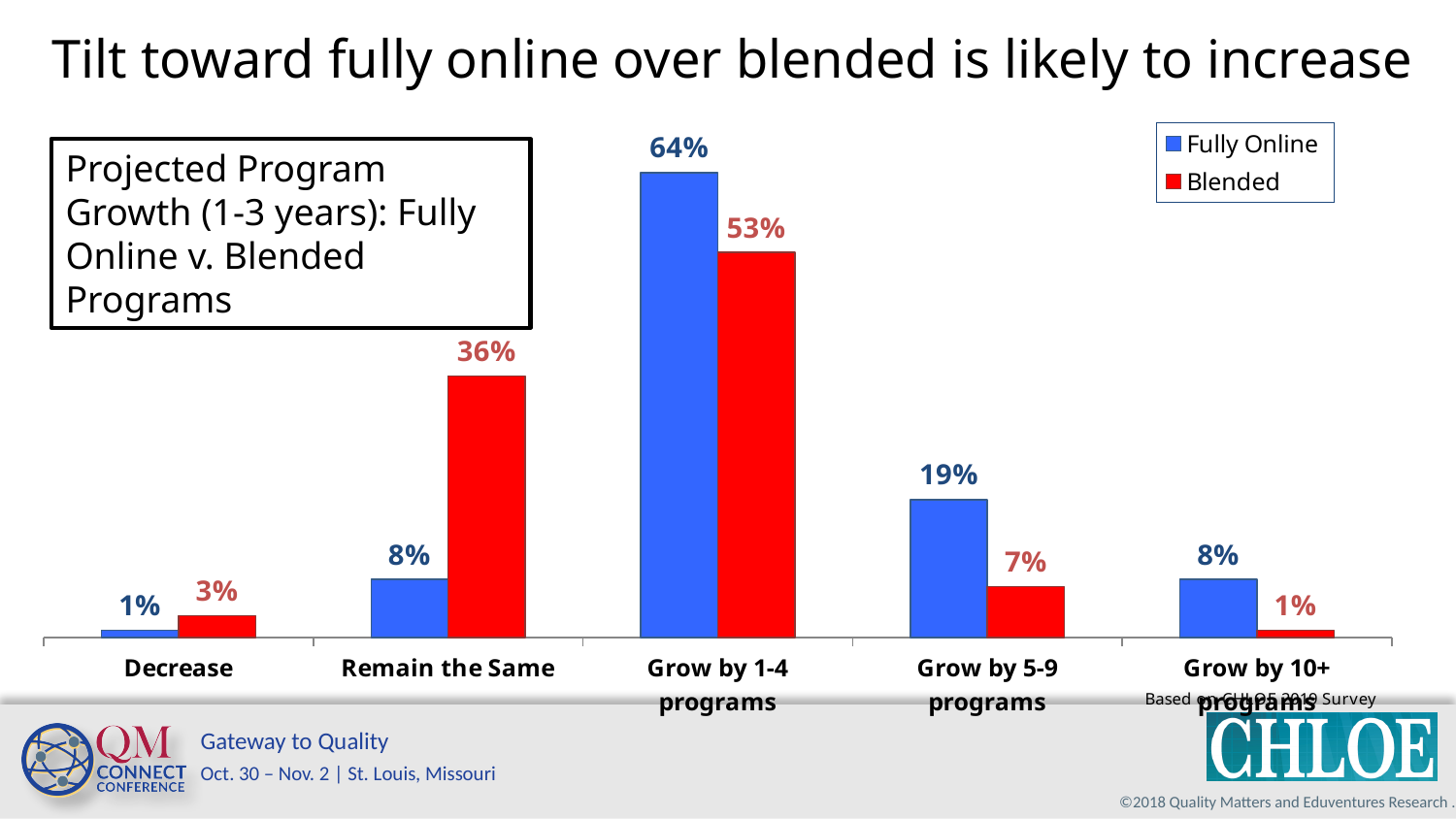
Which category has the lowest Blended value? Grow by 10+ programs Which category has the highest Fully Online value? Grow by 1-4 programs What is the difference between the Blended and Fully Online values for Remain the Same? 28% What is the Fully Online value for Grow by 1-4 programs? 64% How many categories are shown on the x axis? 5 What is the Blended value for Grow by 5-9 programs? 7% How many series does the legend list? 2 What kind of chart is shown on the slide? Bar chart What is the difference between the Fully Online and Blended values for Grow by 1-4 programs? 11% What is the Blended value for Remain the Same? 36% What is the Fully Online value for Decrease? 1% Which is larger for Grow by 5-9 programs, Fully Online or Blended? Fully Online